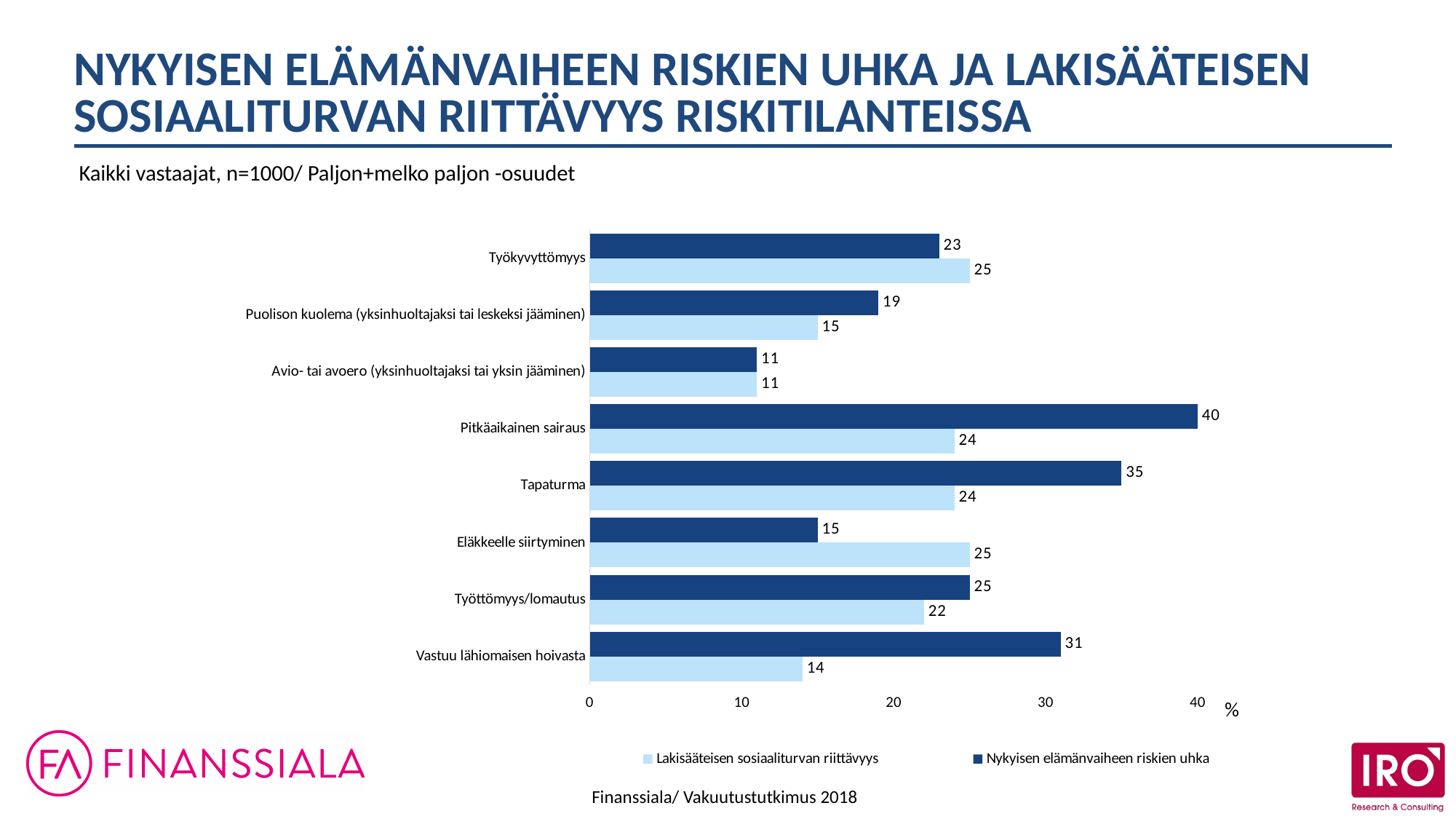
What is the value for 'Lakisääteisen sosiaaliturvan riittävyys' for Eläkkeelle siirtyminen? 25 How many series does the legend list? 2 What is the value for 'Lakisääteisen sosiaaliturvan riittävyys' for Vastuu lähiomaisen hoivasta? 14 What kind of chart is shown on the slide? Bar chart How many categories are shown on the chart? 8 Which category has the highest value for 'Nykyisen elämänvaiheen riskien uhka'? Pitkäaikainen sairaus What is the difference between the 'Nykyisen elämänvaiheen riskien uhka' values for Pitkäaikainen sairaus and Työkyvyttömyys? 17 What is the value for 'Nykyisen elämänvaiheen riskien uhka' for Pitkäaikainen sairaus? 40 Which category has the lowest value for 'Lakisääteisen sosiaaliturvan riittävyys'? Avio- tai avoero (yksinhuoltajaksi tai yksin jääminen) For Tapaturma, which series has the larger value: 'Nykyisen elämänvaiheen riskien uhka' or 'Lakisääteisen sosiaaliturvan riittävyys'? Nykyisen elämänvaiheen riskien uhka Which colour represents 'Lakisääteisen sosiaaliturvan riittävyys' in the legend? Light blue What is the difference between the two series' values for Vastuu lähiomaisen hoivasta? 17